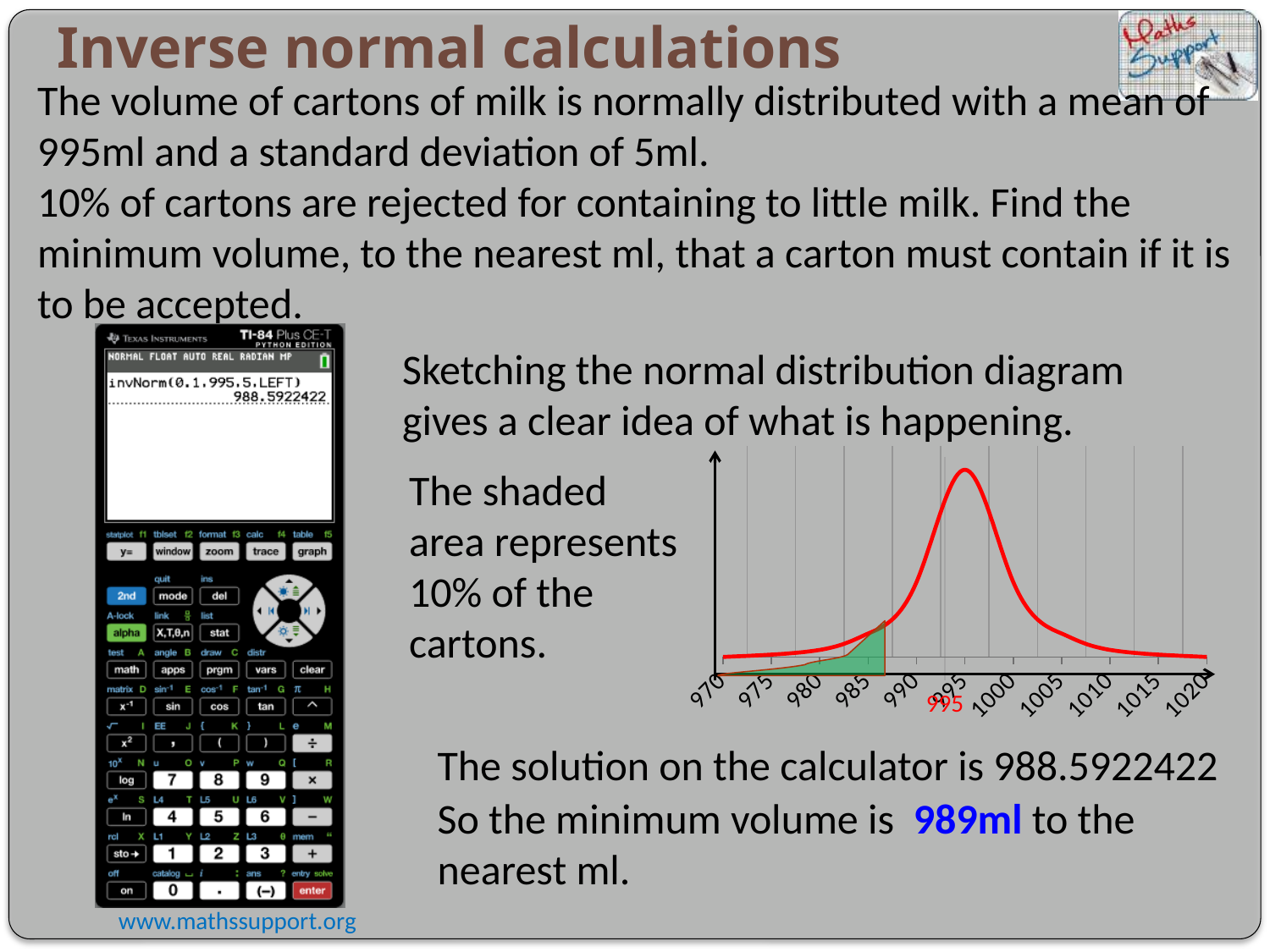
What percentage of the cartons does the shaded area represent? 10% Is the right-hand edge of the shaded region at a value greater or less than 985? greater Does the curve rise or fall as x increases from 970 to 995? rise What is the lowest value labelled on the x axis of the normal distribution diagram? 970 What is the spacing between consecutive tick labels on the x axis? 5 How many labelled tick values are shown on the x axis of the normal distribution diagram? 11 What kind of chart is shown on the right of the slide? line chart (normal distribution curve) At which x-axis value does the red curve reach its peak? 995 Does the curve rise or fall as x increases from 995 to 1020? fall What is the highest value labelled on the x axis of the normal distribution diagram? 1020 What colour is the shaded area under the curve? green Is the right-hand edge of the shaded region at a value greater or less than 990? less